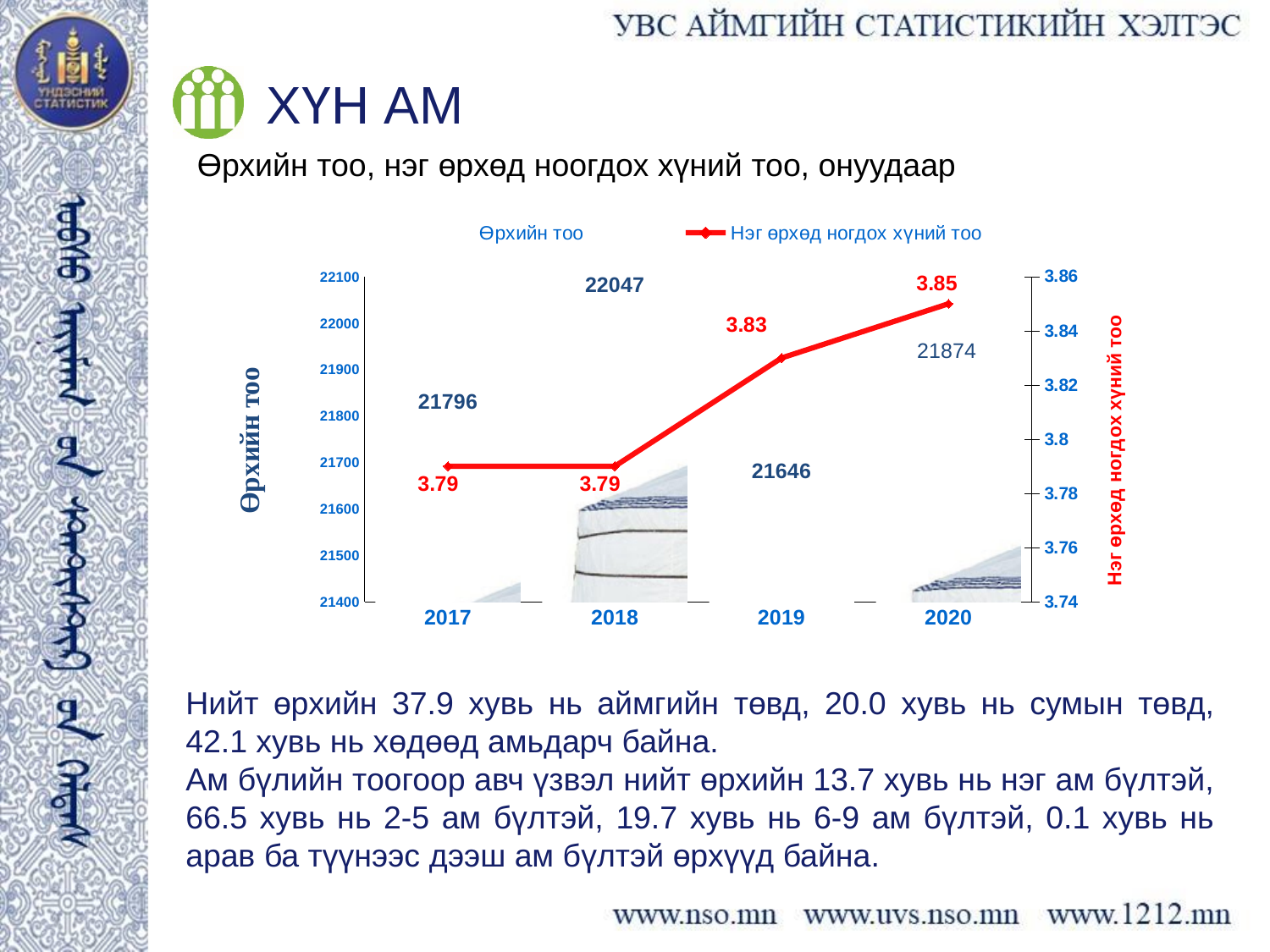
Which year has the lowest number of households (Өрхийн тоо)? 2019 What is the number of households (Өрхийн тоо) in 2018? 22047 Is the number of persons per household higher in 2019 or in 2018? 2019 How many years are shown on the x axis of the chart? 4 Which year has the highest number of households (Өрхийн тоо)? 2018 What is the number of persons per household (Нэг өрхөд ногдох хүний тоо) in 2020? 3.85 What colour is the line for Нэг өрхөд ногдох хүний тоо? red What is the difference in persons per household between 2020 and 2017? 0.06 How many series does the chart legend list? 2 What is the difference in the number of households between 2018 and 2019? 401 Does the number of persons per household (Нэг өрхөд ногдох хүний тоо) rise or fall from 2018 to 2020? rise What is the number of households (Өрхийн тоо) in 2019? 21646